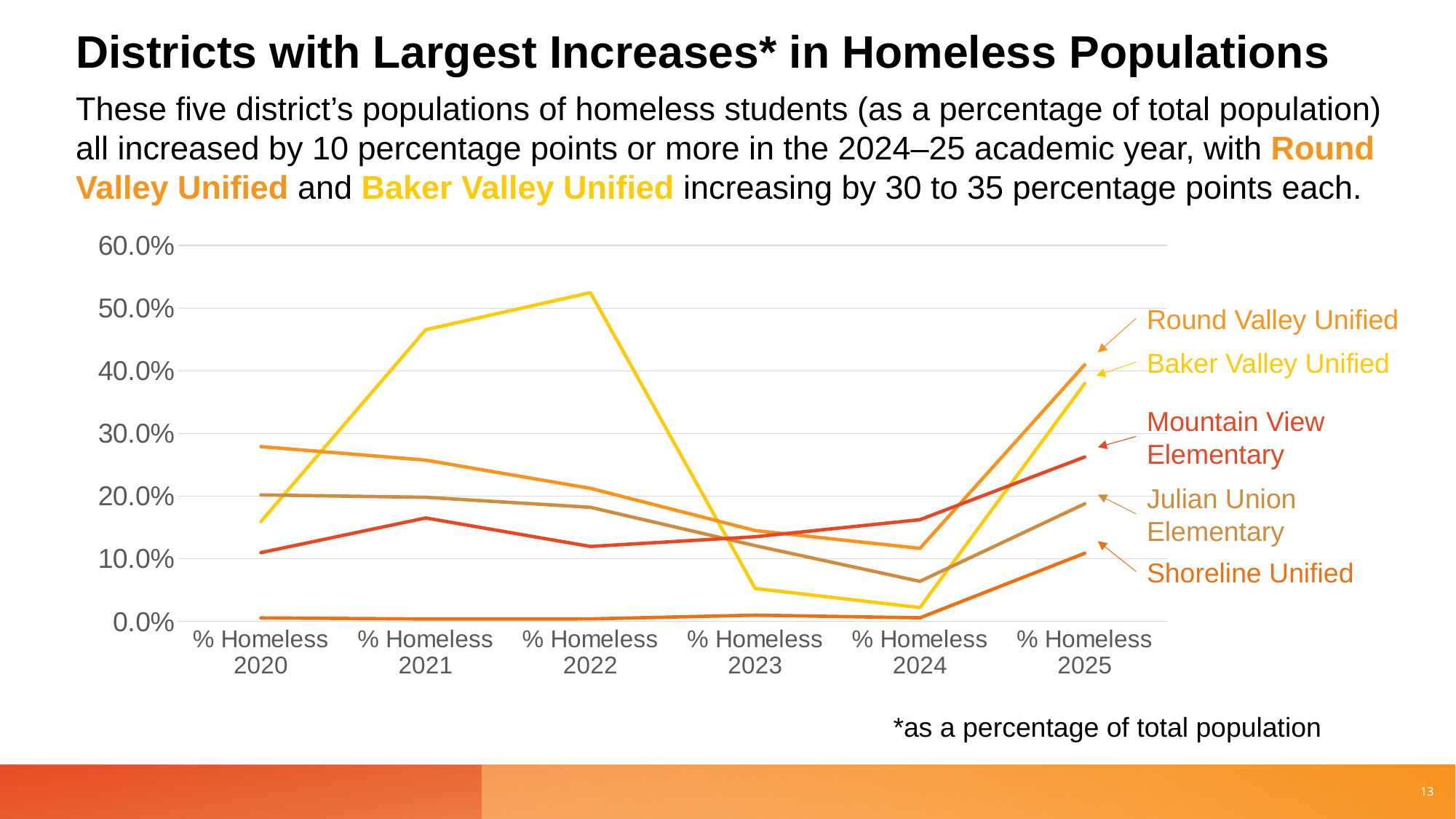
What kind of chart is shown on the slide? line chart How many districts are plotted as lines on the chart? 5 Which district has the lowest value in 2025? Shoreline Unified Is the value for Baker Valley Unified in 2022 greater or less than 50.0%? greater What is the highest value labelled on the y axis of the chart? 60.0% In 2020, which is larger: the value for Round Valley Unified or for Julian Union Elementary? Round Valley Unified How many years are shown along the x axis of the chart? 6 Is the value for Round Valley Unified in 2020 greater or less than 20.0%? greater Which district has the highest value in 2025? Round Valley Unified Which district has the highest value in 2022? Baker Valley Unified Does the Baker Valley Unified line rise or fall from 2022 to 2024? fall Is the value for Shoreline Unified in 2023 greater or less than 10.0%? less